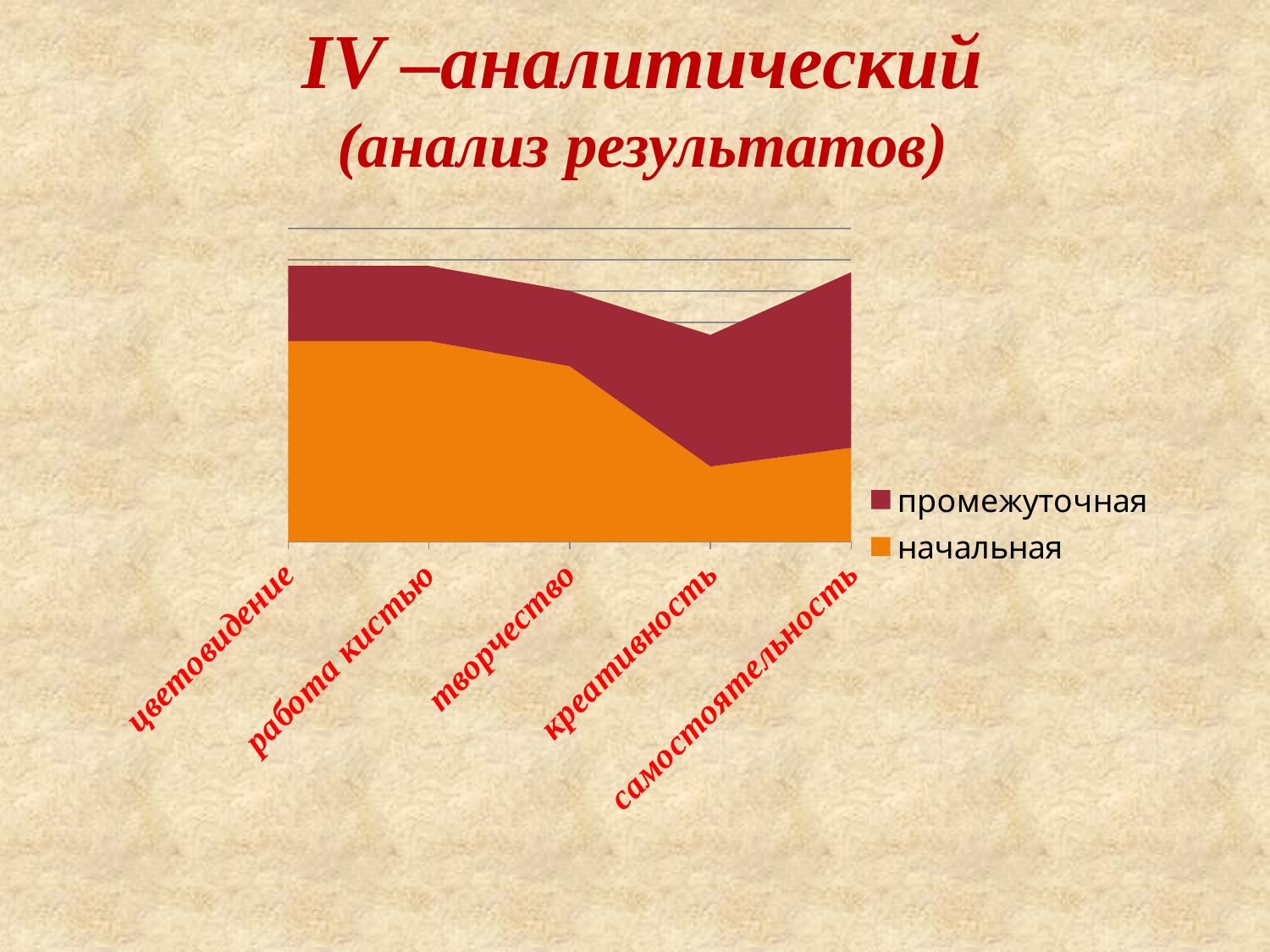
How many series does the chart's legend list? 2 How many categories are shown along the x axis of the chart? 5 Is the начальная value larger for работа кистью or for самостоятельность? работа кистью Which category is the last one on the x axis? самостоятельность For which category is the начальная value lowest? креативность Is the начальная value larger for цветовидение or for креативность? цветовидение Does the начальная series rise or fall from работа кистью to креативность? fall What kind of chart is shown on the slide? stacked area chart Does the stacked total rise or fall from креативность to самостоятельность? rise Which series is shown in orange in the chart? начальная Which series is shown in dark red in the chart? промежуточная For which category is the combined (stacked) total of both series lowest? креативность